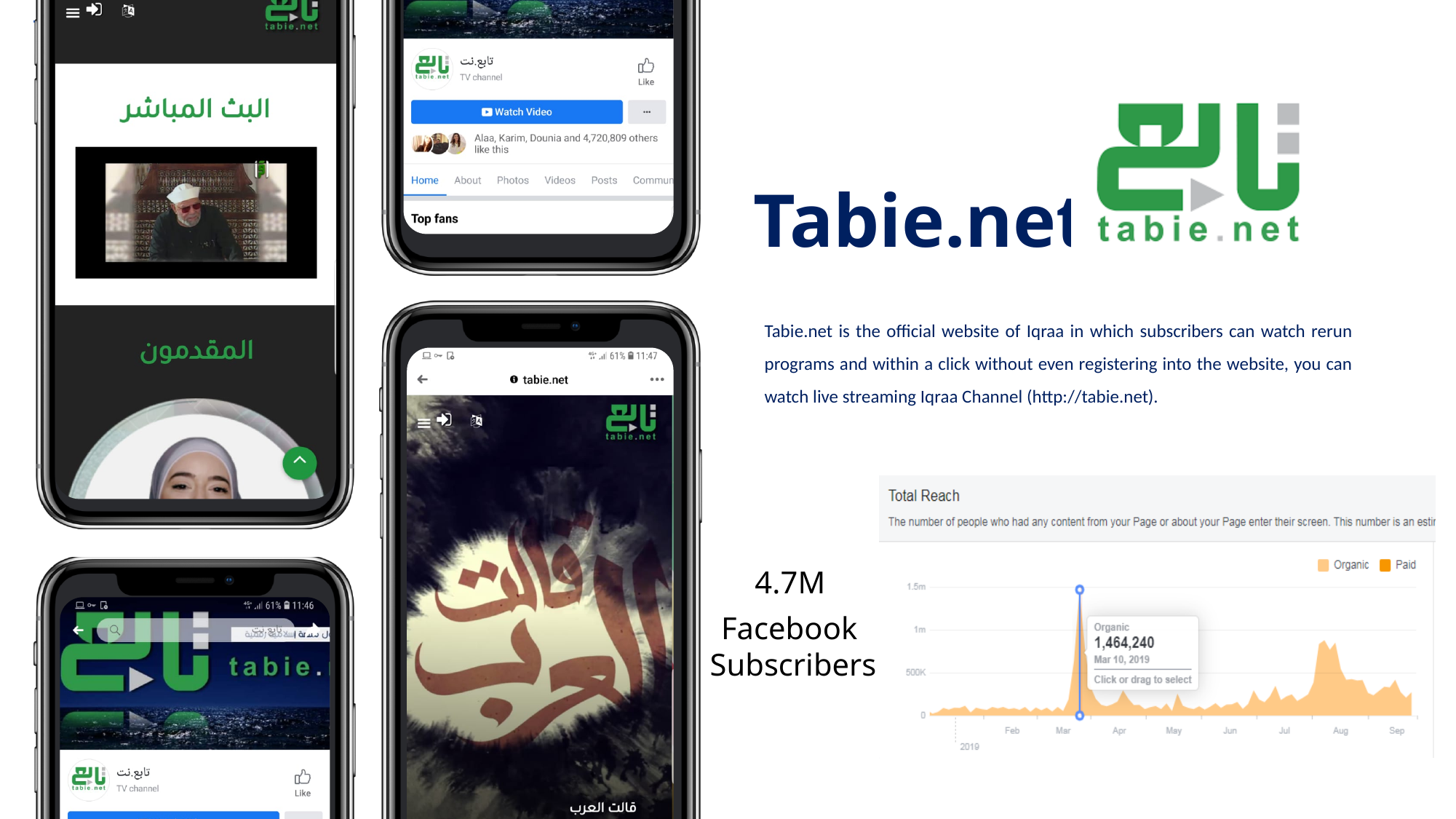
What Organic value is shown in the tooltip on the Total Reach chart for Mar 10, 2019? 1,464,240 How many series does the legend of the Total Reach chart list? 2 Is the reach in February on the Total Reach chart greater or less than 500K? less What are the two series named in the legend of the Total Reach chart? Organic and Paid Is the peak value in August on the Total Reach chart greater or less than 1m? less On the Total Reach chart, which peak is larger: the one in March or the one in August? March Is the peak value in March on the Total Reach chart greater or less than 1m? greater How many month labels are shown on the x axis of the Total Reach chart? 8 In which month does the Total Reach chart show its highest peak? Mar What kind of chart is the Total Reach chart? Area chart What is the title of the chart on the slide? Total Reach